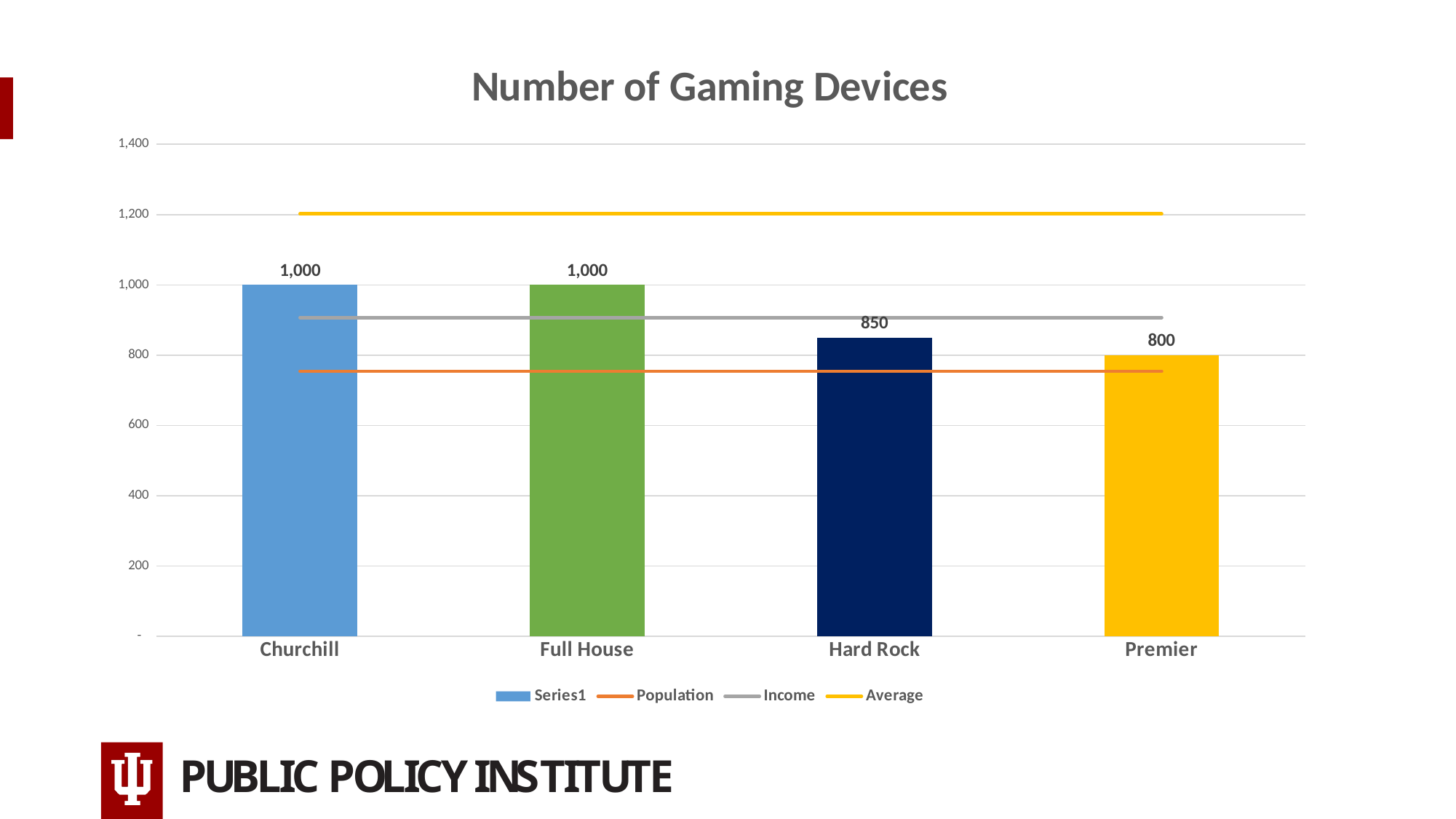
What is the number of gaming devices for Premier? 800 Which category has the lowest number of gaming devices? Premier What is the difference between the number of gaming devices for Full House and Hard Rock? 150 How many categories are shown on the x axis? 4 How many series does the legend list? 4 What is the difference between the number of gaming devices for Hard Rock and Premier? 50 Is the value of the Population line greater or less than 800? less What is the number of gaming devices for Churchill? 1,000 What is the number of gaming devices for Hard Rock? 850 Is the value of the Average line greater or less than 1,000? greater Which has more gaming devices, Hard Rock or Premier? Hard Rock What is the title of the chart? Number of Gaming Devices